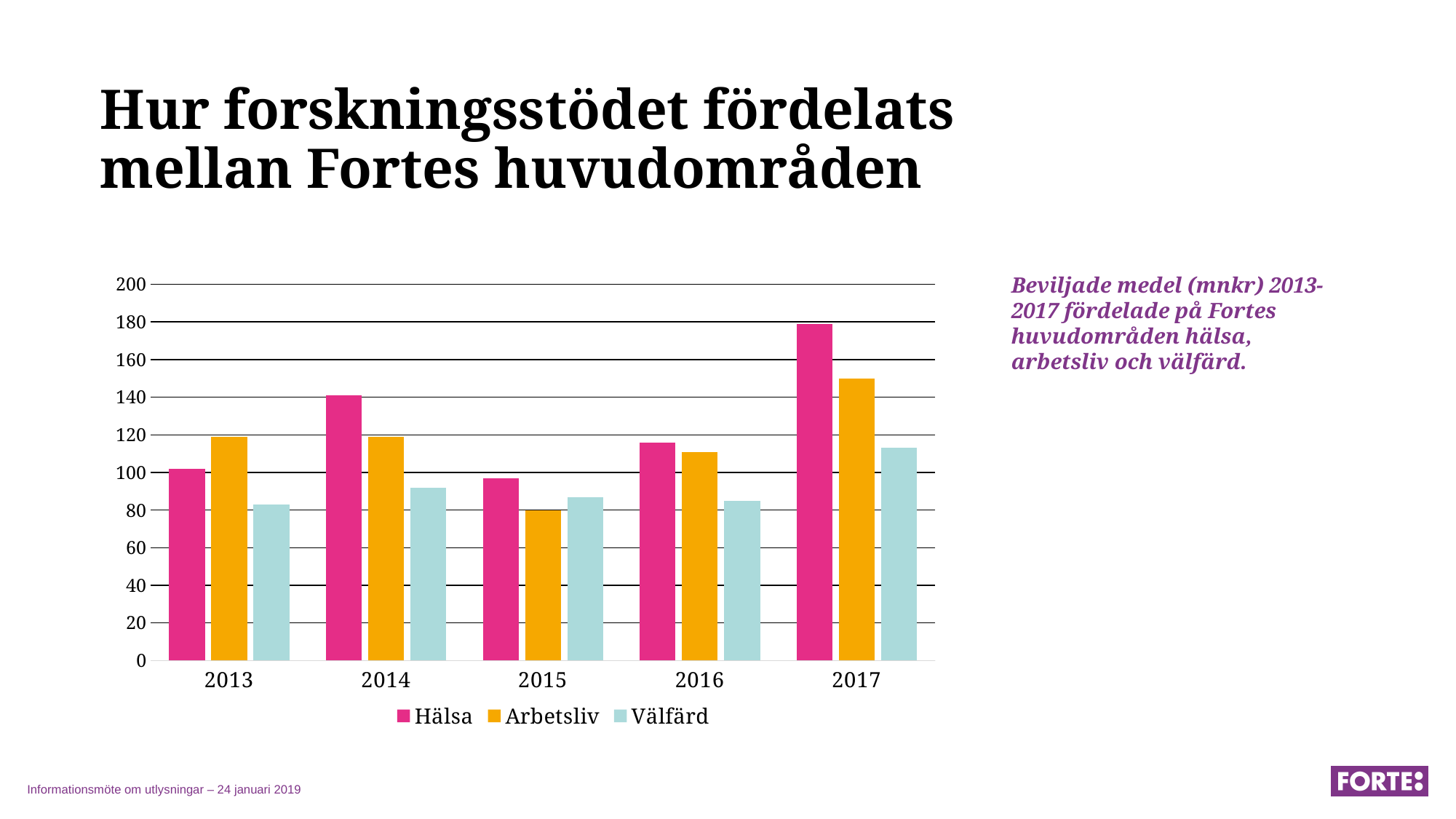
How many series does the legend list? 3 What kind of chart is shown on the slide? bar chart In which year is the Hälsa value highest? 2017 In which year is the Arbetsliv value lowest? 2015 Is the value for Hälsa in 2014 greater or less than 120? greater How many years are shown on the x axis? 5 In 2013, which is larger: Hälsa or Arbetsliv? Arbetsliv In 2014, which is larger: Hälsa or Arbetsliv? Hälsa Is the value for Arbetsliv in 2017 greater or less than 140? greater Is the value for Välfärd in 2013 greater or less than 100? less Which series is shown in pink in the legend? Hälsa